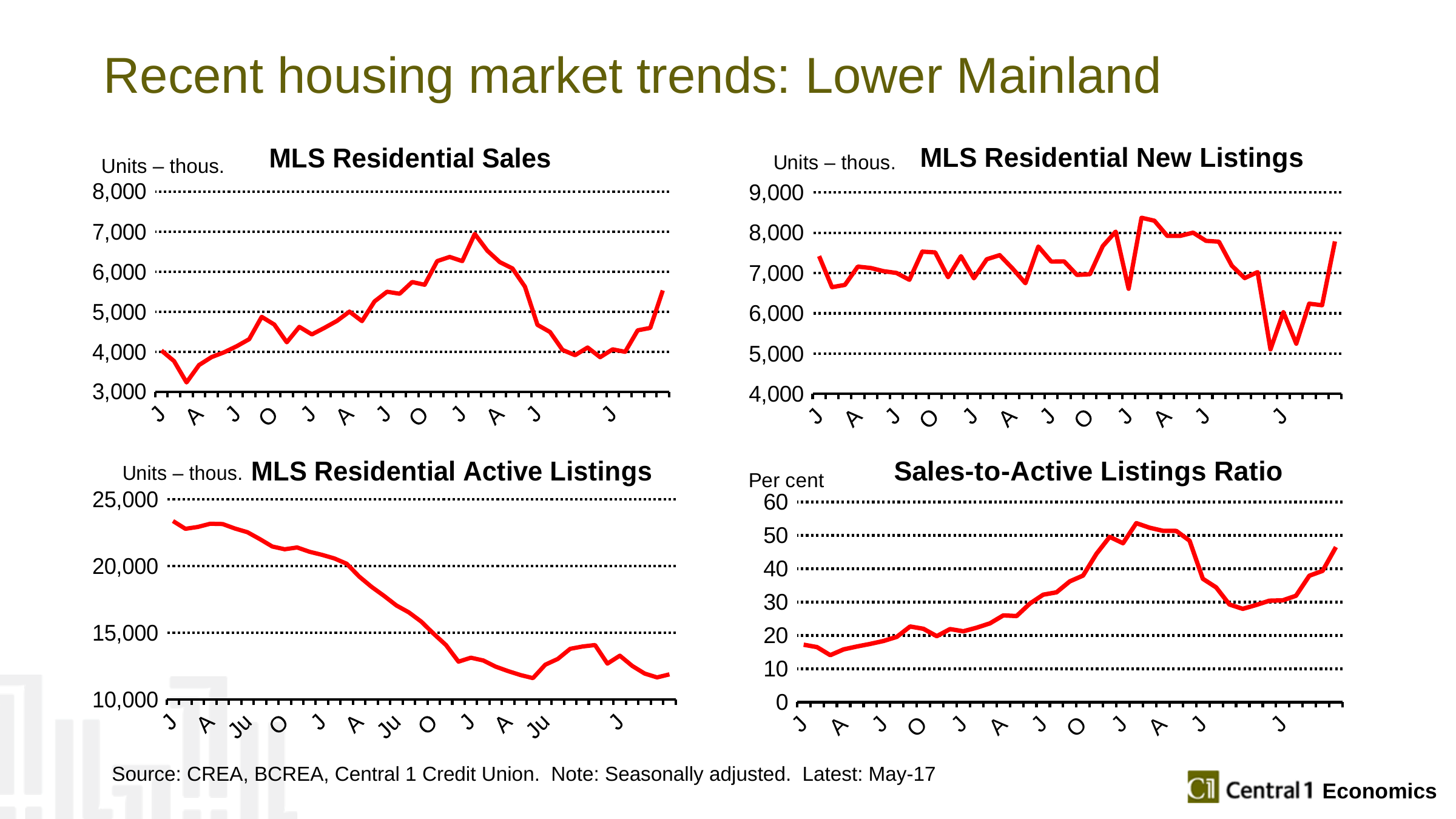
In the MLS Residential New Listings chart, is the highest point of the line greater or less than 8,000? greater In the MLS Residential Active Listings chart, do the values overall rise or fall from the start to the end of the series? fall In the MLS Residential New Listings chart, is the lowest point of the line greater or less than 6,000? less What unit label is shown on the vertical axis of the Sales-to-Active Listings Ratio chart? Per cent In the MLS Residential Sales chart, is the lowest point of the line greater or less than 4,000? less What unit label is shown on the vertical axis of the MLS Residential Sales chart? Units – thous. What kind of chart is the MLS Residential Sales chart? line chart